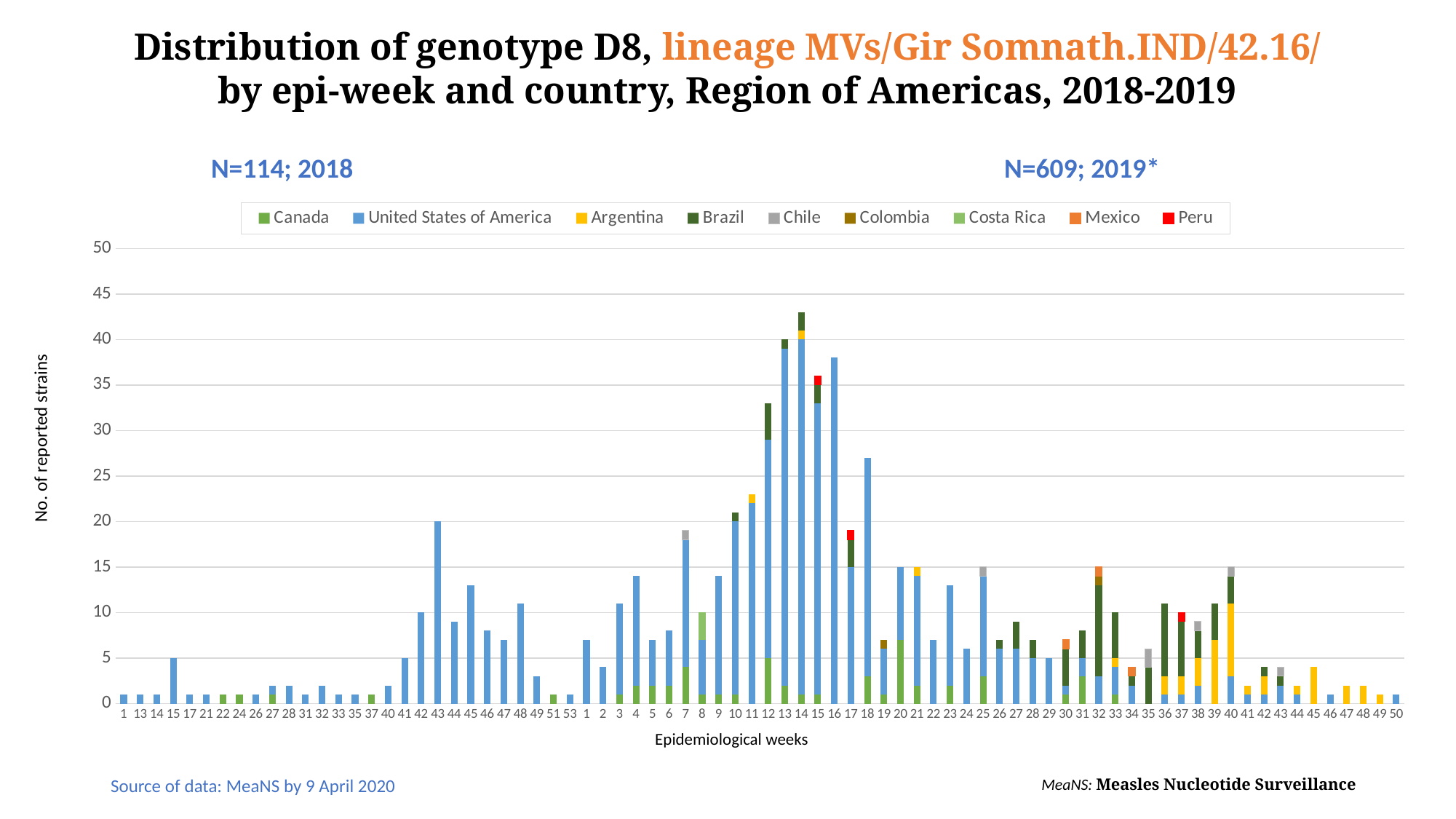
What kind of chart is shown on the slide? Stacked bar chart Is the value for week 18 of 2019 greater or less than 25? greater What is the label of the y-axis? No. of reported strains Is the value for week 14 of 2019 greater or less than 40? greater Which epidemiological week has the highest number of reported strains? Week 14 of 2019 How many countries (series) does the legend list? 9 Which is larger, the bar for week 43 of 2018 or the bar for week 45 of 2018? Week 43 of 2018 Is the value for week 16 of 2019 greater or less than 35? greater Which is larger, the bar for week 14 of 2019 or the bar for week 16 of 2019? Week 14 of 2019 Do the values rise or fall from week 14 to week 18 of 2019? fall